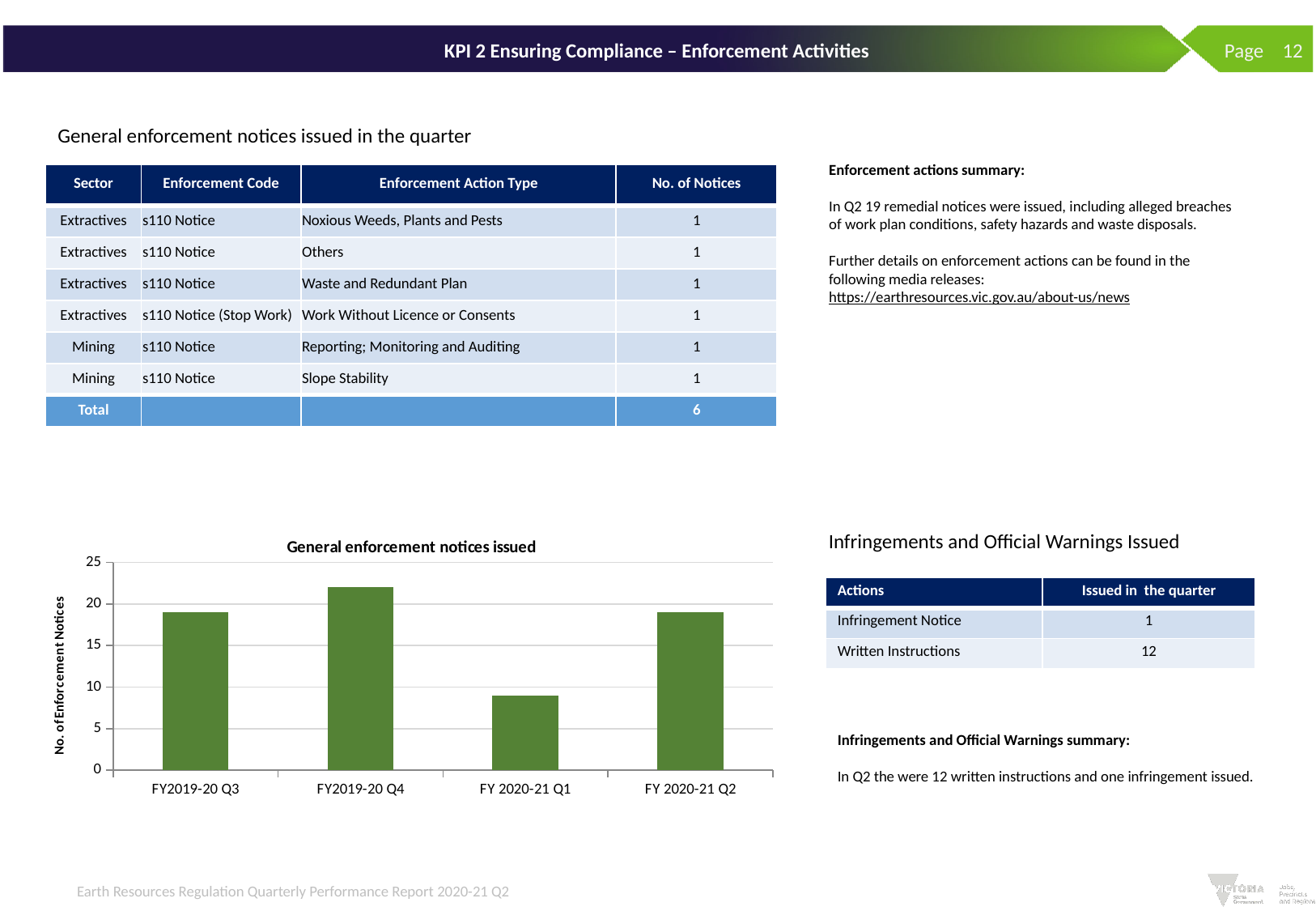
What kind of chart is shown on the slide? bar chart Which quarter has the lowest number of enforcement notices in the chart? FY 2020-21 Q1 Is the value for FY2019-20 Q4 greater or less than 20? greater What is the title of the chart? General enforcement notices issued Which quarter has more enforcement notices, FY2019-20 Q4 or FY 2020-21 Q1? FY2019-20 Q4 Which quarter has the highest number of enforcement notices in the chart? FY2019-20 Q4 What is the label on the vertical axis of the chart? No. of Enforcement Notices Is the value for FY2019-20 Q3 greater or less than 15? greater Does the number of enforcement notices rise or fall from FY2019-20 Q4 to FY 2020-21 Q1? fall Is the value for FY 2020-21 Q1 greater or less than 10? less How many quarters are plotted in the 'General enforcement notices issued' chart? 4